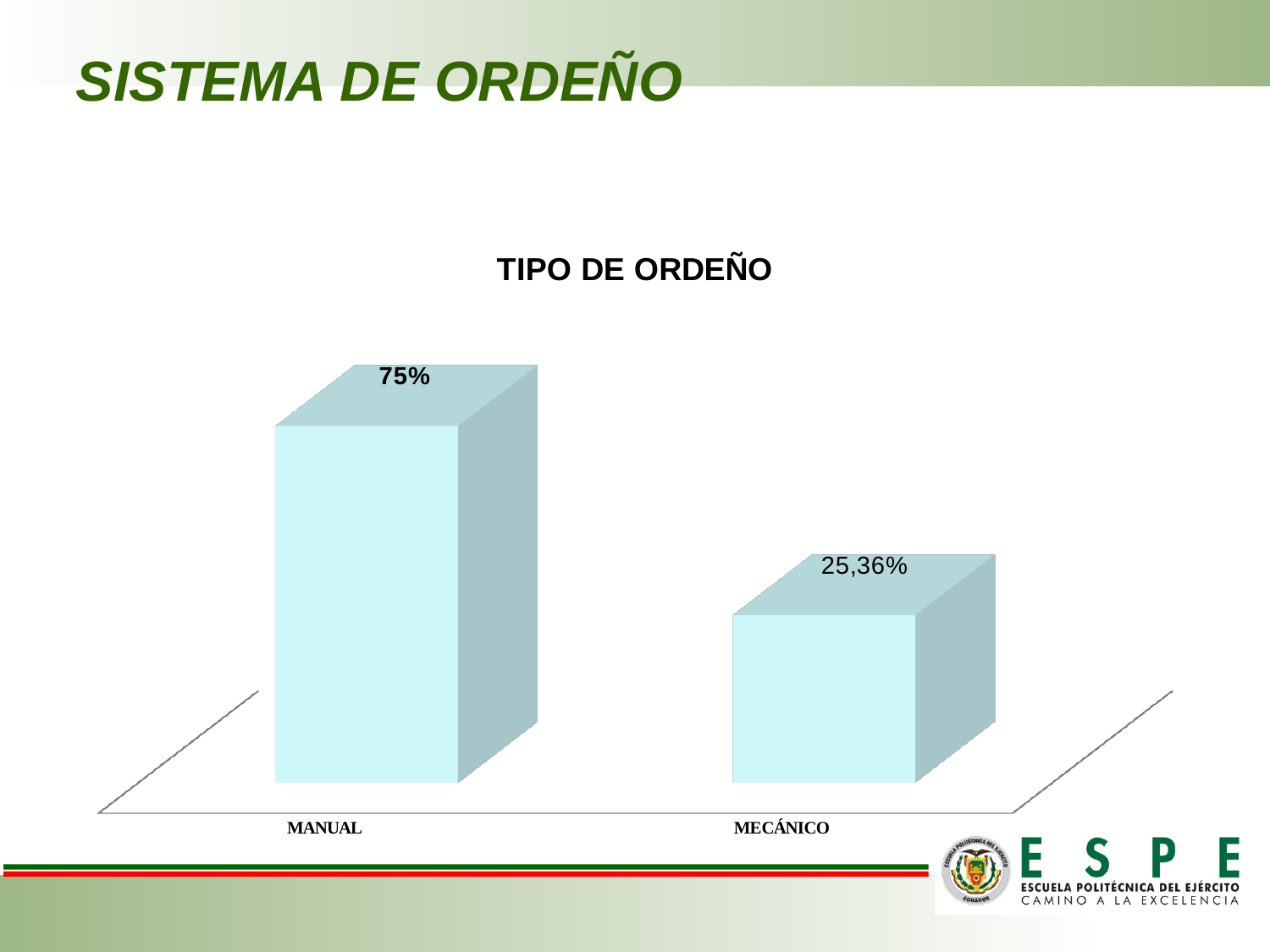
Which is larger, the value for MANUAL or the value for MECÁNICO? MANUAL Do the values rise or fall from MANUAL to MECÁNICO? Fall How many categories are shown in the chart? 2 What is the title of the slide? SISTEMA DE ORDEÑO What is the value for MANUAL? 75% Which category has the lowest value? MECÁNICO What is the difference between the values for MANUAL and MECÁNICO? 49,64% Which category has the highest value? MANUAL What kind of chart is shown on the slide? Bar chart What is the title of the chart? TIPO DE ORDEÑO What is the value for MECÁNICO? 25,36%